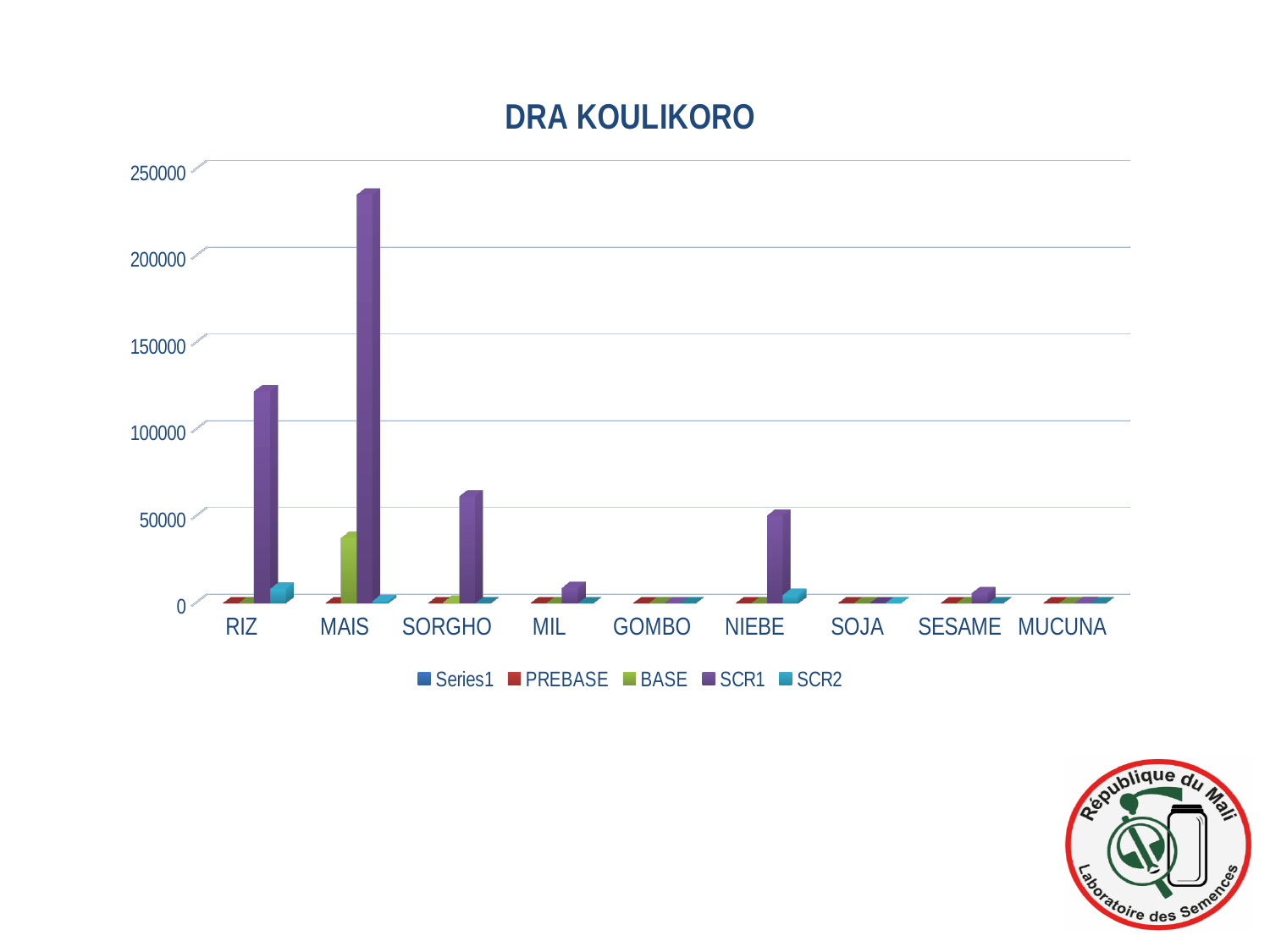
Is the SCR1 value for SORGHO greater or less than 100000? less What kind of chart is shown on the slide? Bar chart Which has a larger SCR1 value, NIEBE or MIL? NIEBE Is the SCR1 value for RIZ greater or less than 100000? greater Is the BASE value for MAIS greater or less than 50000? less Which series is shown in purple in the legend? SCR1 What is the title of the chart? DRA KOULIKORO How many series does the legend list? 5 How many categories are shown on the x axis? 9 Which has a larger SCR1 value, RIZ or SORGHO? RIZ Which category has the highest SCR1 value? MAIS